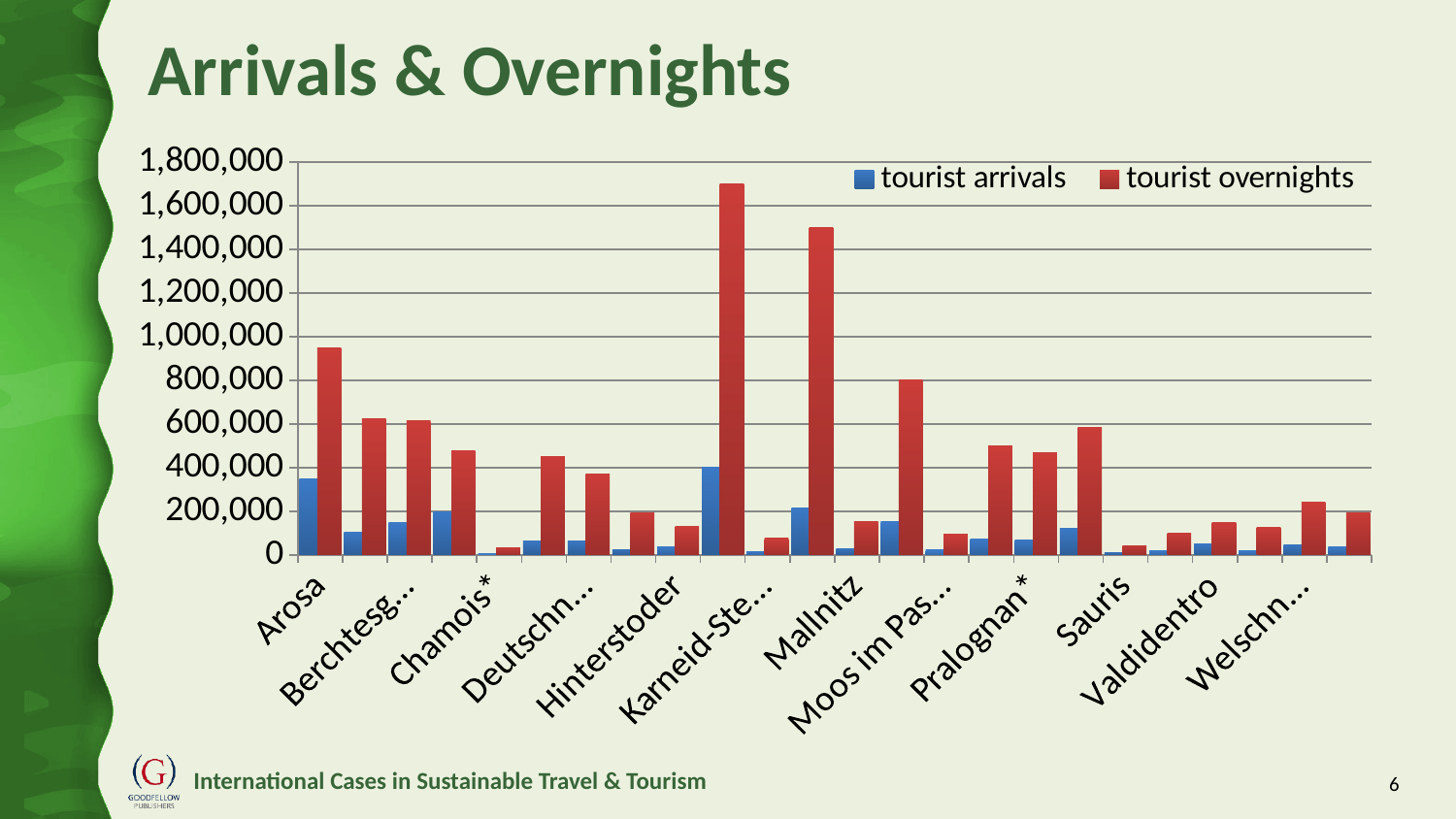
Is the tourist arrivals value for Arosa greater or less than 200,000? greater Which has more tourist overnights, Arosa or Mallnitz? Arosa Which has more tourist overnights, Pralognan* or Hinterstoder? Pralognan* How many series does the legend list? 2 What are the two series named in the legend? tourist arrivals and tourist overnights What is the title of the slide containing the chart? Arrivals & Overnights Is the tourist overnights value for Sauris greater or less than 200,000? less Which has more tourist arrivals, Arosa or Valdidentro? Arosa What kind of chart is shown on the slide? bar chart Is the tourist overnights value for Arosa greater or less than 800,000? greater